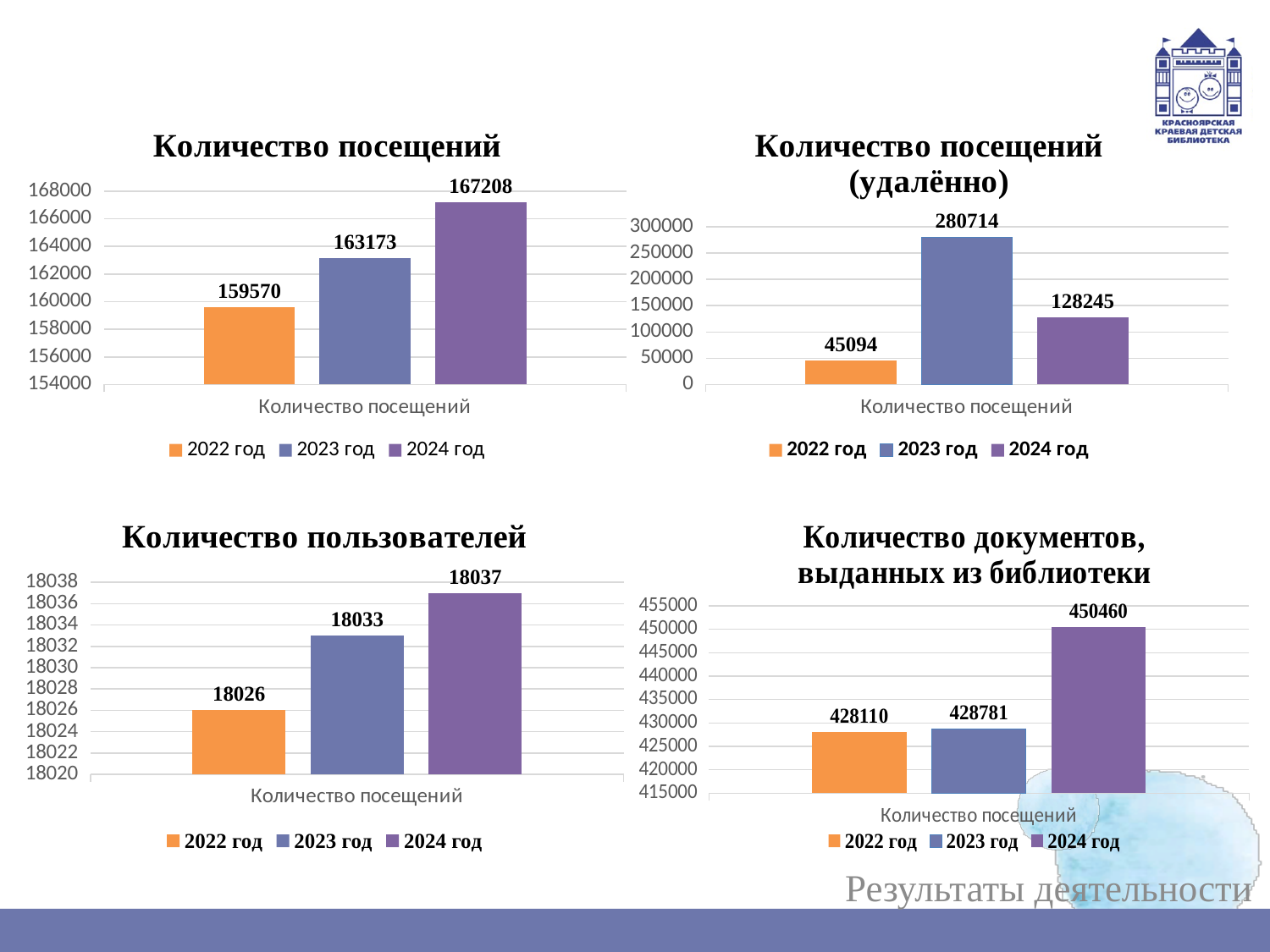
In the chart titled "Количество посещений" (top left), what is the difference between the 2024 год and 2023 год values? 4035 In the chart titled "Количество посещений (удалённо)" (top right), which is larger: the value for 2024 год or the value for 2022 год? 2024 год In the chart titled "Количество посещений (удалённо)" (top right), which year has the highest value? 2023 год In the chart titled "Количество посещений" (top left), do the values rise or fall from 2022 год to 2024 год? rise In the chart titled "Количество посещений" (top left), what is the value for 2023 год? 163173 What kind of chart is the chart titled "Количество документов, выданных из библиотеки" (bottom right)? bar chart In the chart titled "Количество документов, выданных из библиотеки" (bottom right), what is the value for 2024 год? 450460 In the chart titled "Количество пользователей" (bottom left), what is the difference between the 2024 год and 2022 год values? 11 In the chart titled "Количество посещений (удалённо)" (top right), what is the value for 2022 год? 45094 In the chart titled "Количество документов, выданных из библиотеки" (bottom right), which year has the lowest value? 2022 год How many series does the legend list in the chart titled "Количество пользователей" (bottom left)? 3 In the chart titled "Количество посещений (удалённо)" (top right), is the value for 2024 год greater or less than 100000? greater